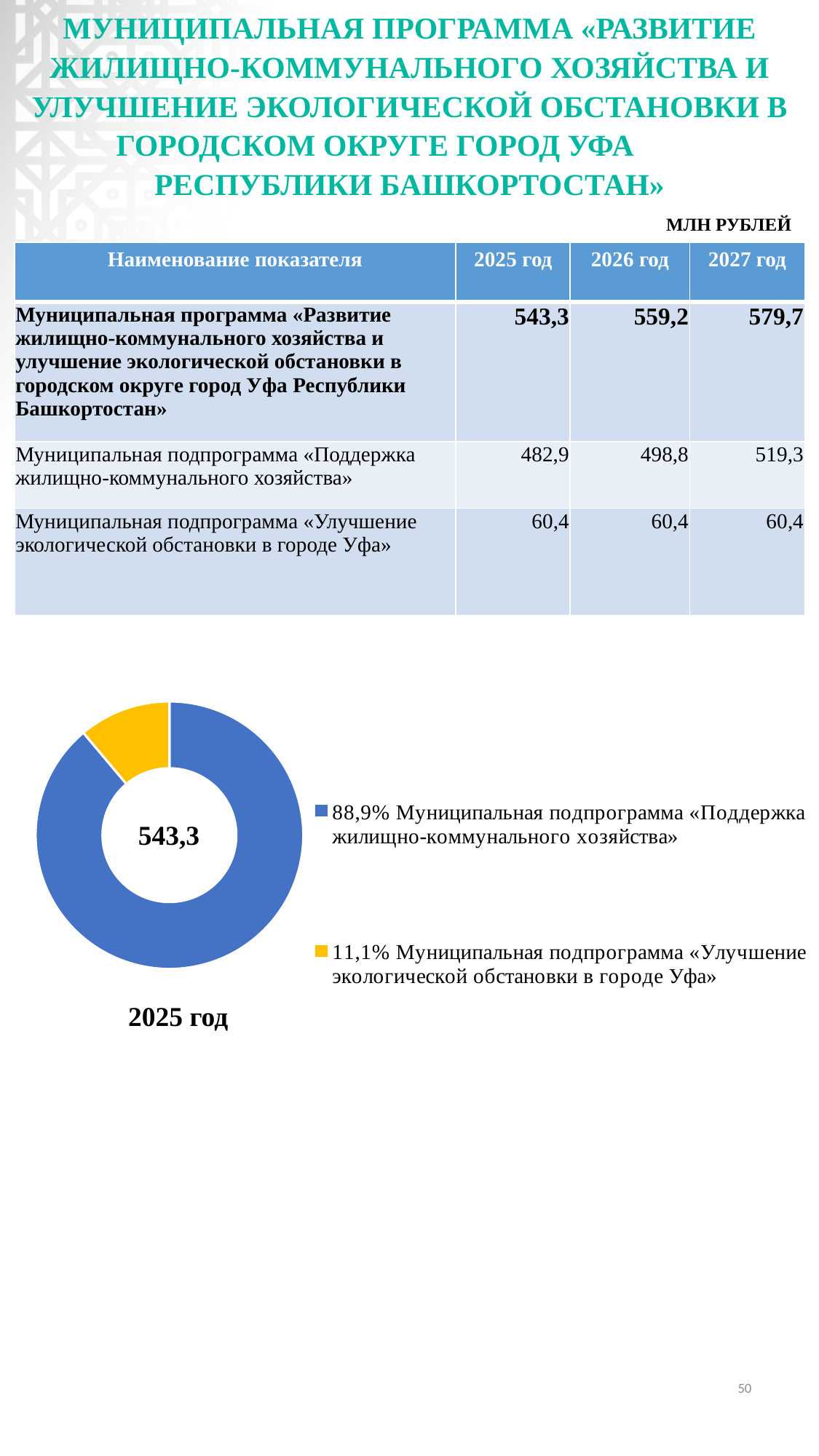
Which subprogram has the smallest slice in the pie chart? Муниципальная подпрограмма «Улучшение экологической обстановки в городе Уфа» What colour is the slice for «Улучшение экологической обстановки в городе Уфа» in the pie chart? yellow What is the difference in percentage points between the two slices of the pie chart? 77,8 Which subprogram has the largest slice in the pie chart? Муниципальная подпрограмма «Поддержка жилищно-коммунального хозяйства» What kind of chart is shown on the slide? doughnut chart Which slice is larger: «Поддержка жилищно-коммунального хозяйства» or «Улучшение экологической обстановки в городе Уфа»? «Поддержка жилищно-коммунального хозяйства» What share of the pie chart does «Улучшение экологической обстановки в городе Уфа» take? 11,1% What share of the pie chart does «Поддержка жилищно-коммунального хозяйства» take? 88,9% What total value is printed in the centre of the pie chart? 543,3 How many slices does the pie chart have? 2 Which year does the pie chart represent? 2025 год